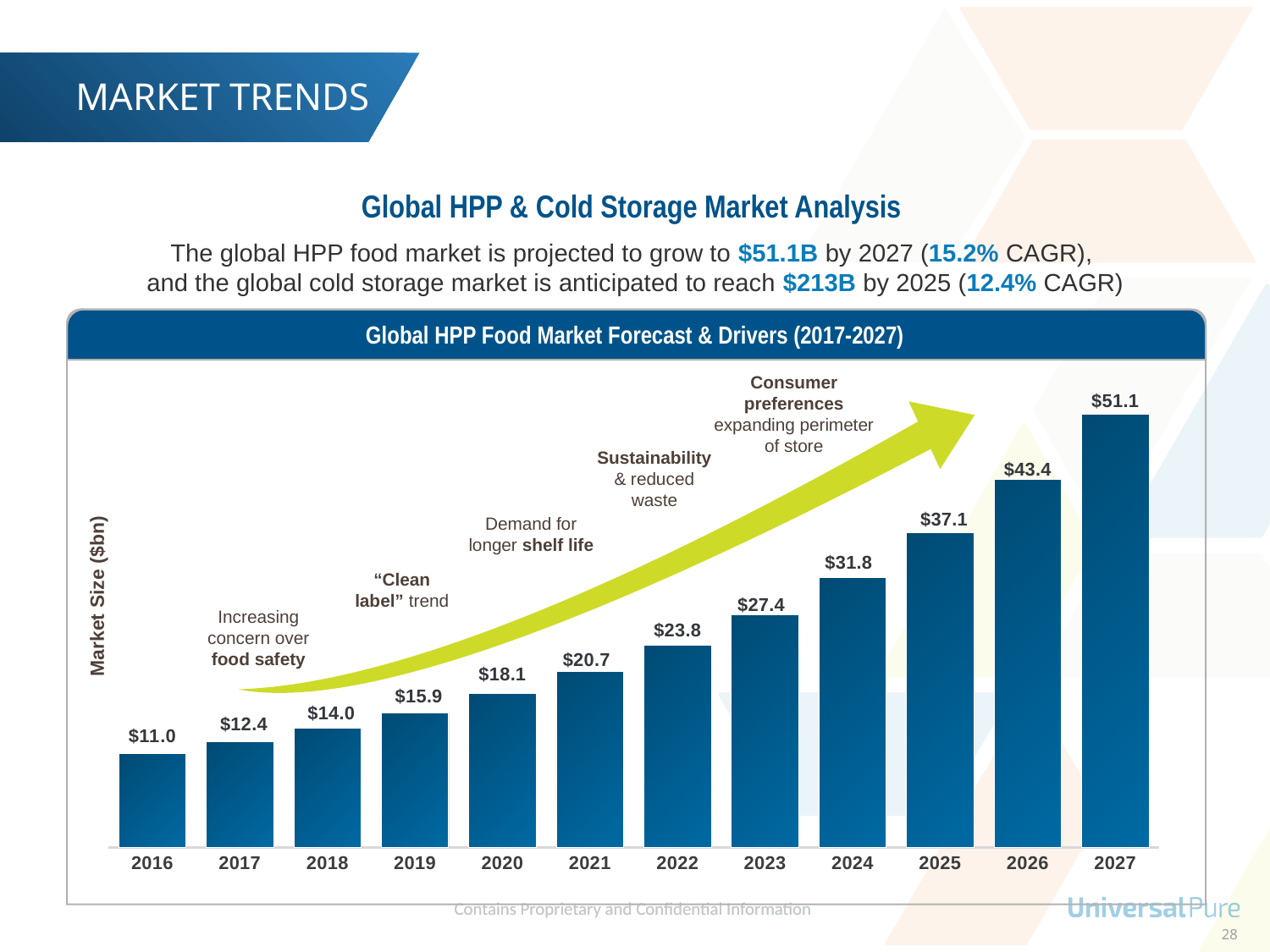
Which year has the lowest market size in the chart? 2016 What is the difference between the market size for 2023 and 2022? $3.6 What is the label on the vertical axis of the chart? Market Size ($bn) What is the title of the chart? Global HPP Food Market Forecast & Drivers (2017-2027) What kind of chart is shown on the slide? Bar chart What is the market size shown for 2020? $18.1 What is the difference between the market size for 2027 and 2016? $40.1 Which year has a larger market size, 2019 or 2021? 2021 What is the market size shown for 2024? $31.8 How many years are plotted in the chart? 12 Which year has the highest market size in the chart? 2027 Do the market size values rise or fall from 2016 to 2027? Rise